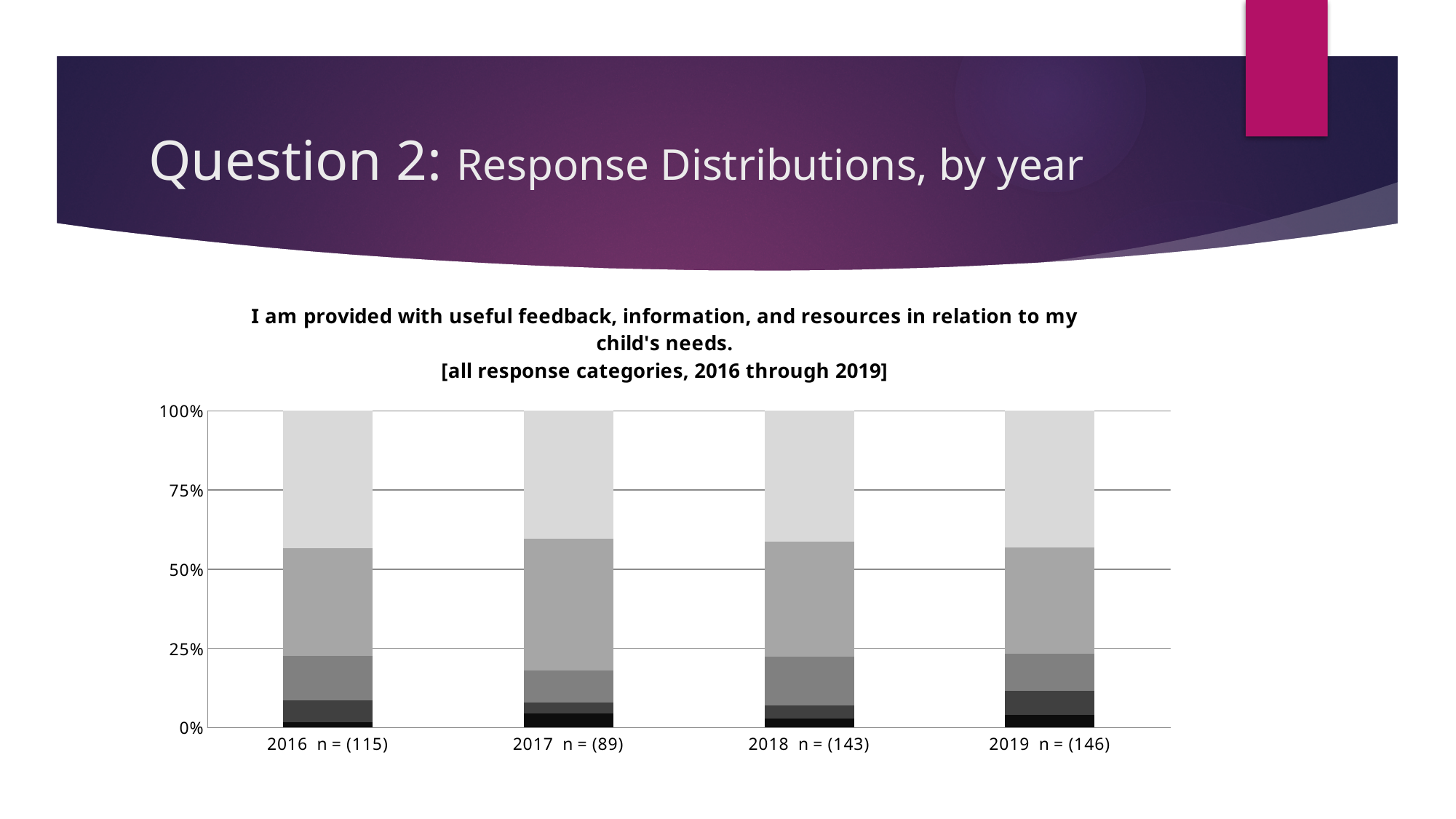
What sample size (n) is shown for 2017 on the x axis? 89 What sample size (n) is shown for 2018 on the x axis? 143 What sample size (n) is shown for 2019 on the x axis? 146 Which year has the largest sample size (n) shown on the x axis? 2019 In the 2017 bar, is the boundary between the lightest (top) segment and the segment below it greater or less than 50%? greater What kind of chart is shown on the slide? Stacked bar chart Which year has the smallest sample size (n) shown on the x axis? 2017 In the 2016 bar, is the top of the darkest (bottom) segment greater or less than 25%? less What sample size (n) is shown for 2016 on the x axis? 115 What is the highest value shown on the y axis of the chart? 100% What is the total height of each stacked bar in the chart? 100% How many years (bars) are shown on the x axis of the chart? 4